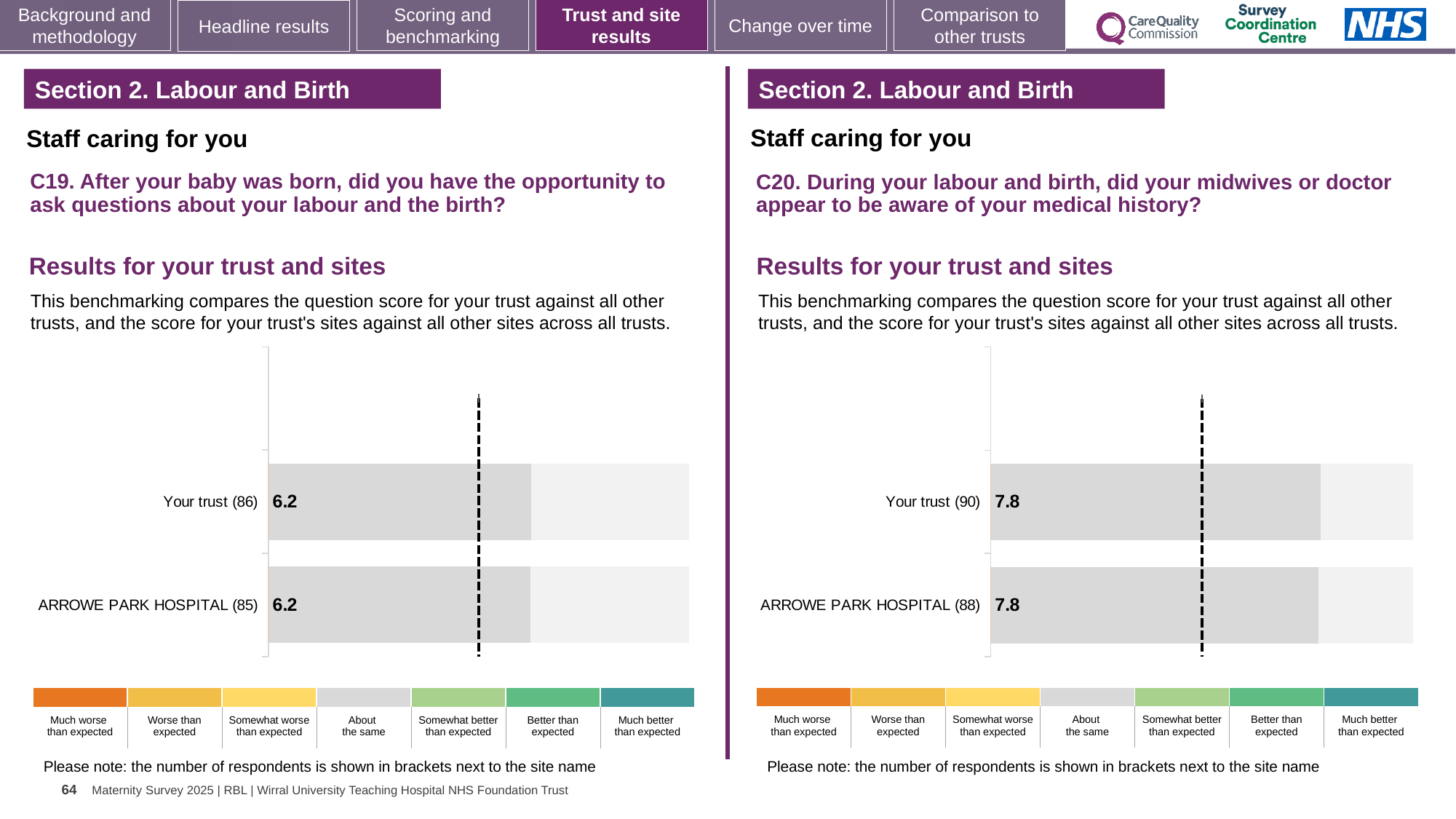
In the C20 chart on the right, what is the score for Your trust? 7.8 In the C19 chart on the left, how many respondents are shown in brackets for Your trust? 86 Is the score for Your trust in the C20 chart on the right larger than the score for Your trust in the C19 chart on the left? Yes In the C20 chart on the right, how many respondents are shown in brackets for ARROWE PARK HOSPITAL? 88 How many bars are plotted in the C19 chart on the left? 2 In the C20 chart on the right, what is the difference between the score for Your trust and the score for ARROWE PARK HOSPITAL? 0 How many bars are plotted in the C20 chart on the right? 2 In the C19 chart on the left, what is the score for ARROWE PARK HOSPITAL? 6.2 In the C20 chart on the right, what is the score for ARROWE PARK HOSPITAL? 7.8 What kind of chart is used for the C19 results on the left? Bar chart In the C19 chart on the left, what is the difference between the score for Your trust and the score for ARROWE PARK HOSPITAL? 0 In the C19 chart on the left, what is the score for Your trust? 6.2